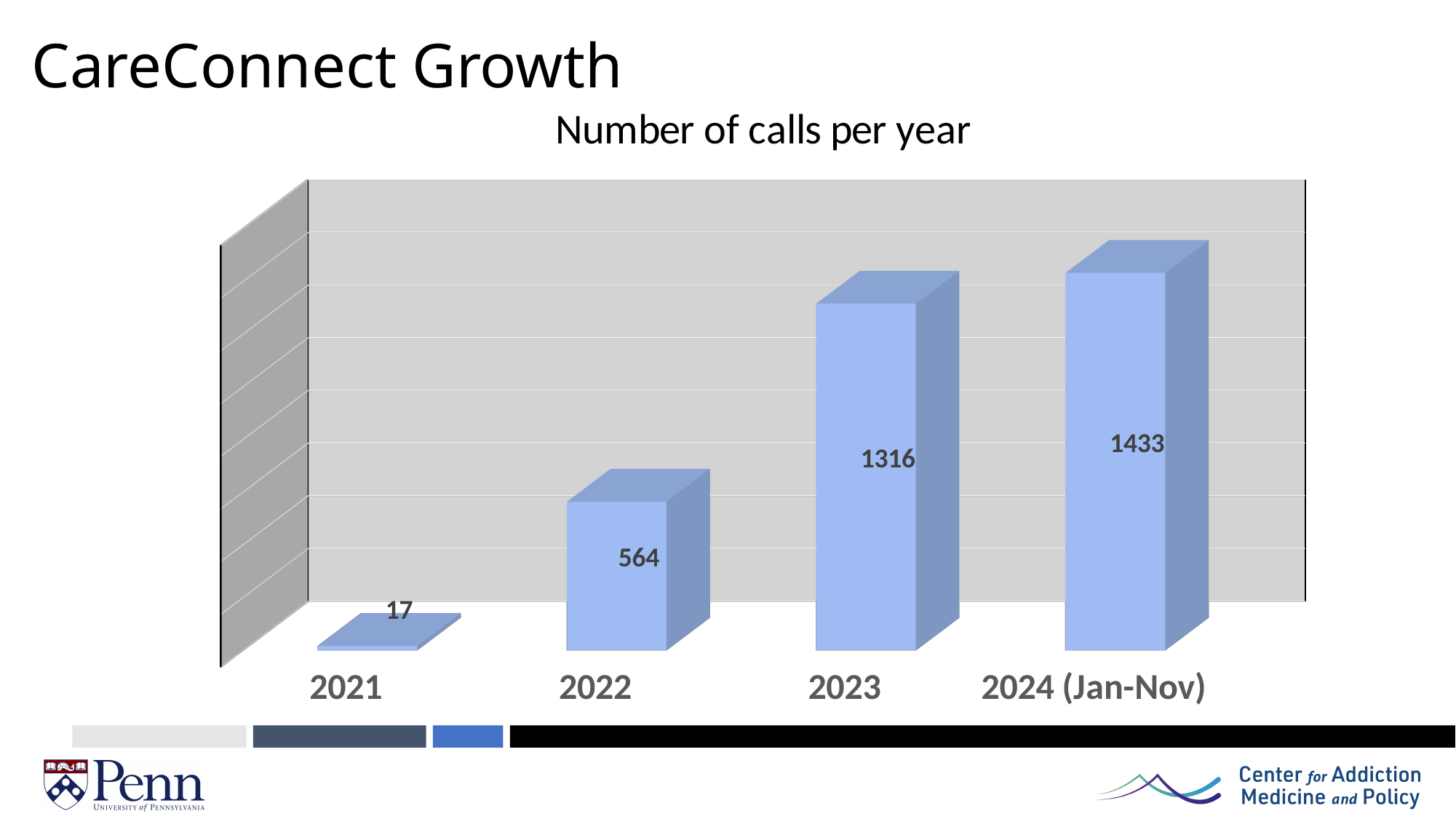
What is the number of calls for 2022? 564 What is the difference in number of calls between 2024 (Jan-Nov) and 2023? 117 Do the number of calls rise or fall from 2021 to 2024 (Jan-Nov)? Rise How many years are shown on the chart? 4 What is the number of calls for 2021? 17 What kind of chart is shown on the slide? Bar chart What is the number of calls for 2023? 1316 What is the difference in number of calls between 2023 and 2022? 752 Which year has the highest number of calls? 2024 (Jan-Nov) Which year has the lowest number of calls? 2021 What is the number of calls for 2024 (Jan-Nov)? 1433 Which has more calls, 2022 or 2023? 2023